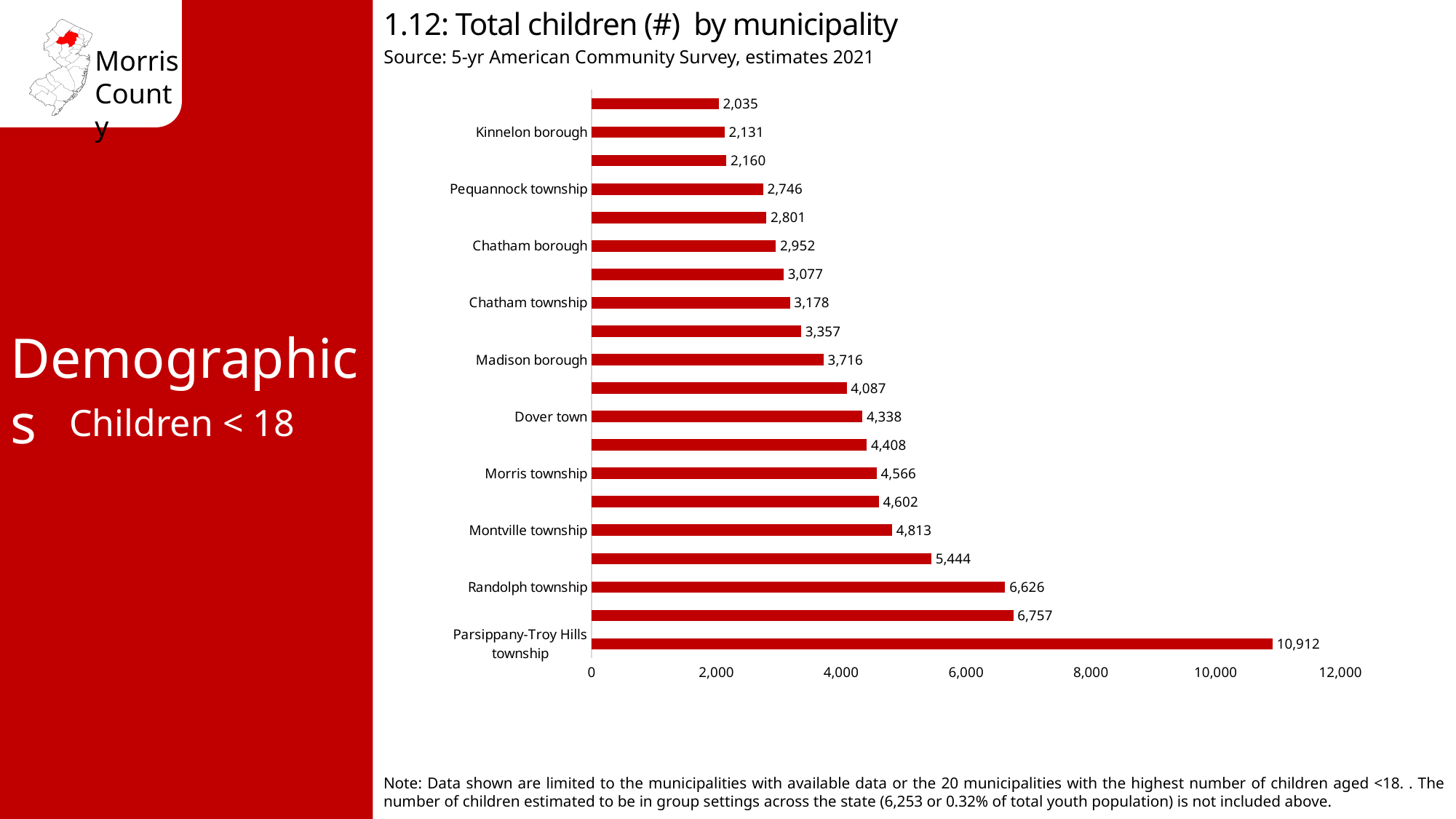
What is the value for Madison borough? 3,716 What kind of chart is shown on the slide? bar chart Is the value for Chatham borough greater or less than 4,000? less Which municipality has the highest number of children? Parsippany-Troy Hills township What is the difference between Morris township and Dover town? 228 What is the value for Parsippany-Troy Hills township? 10,912 What is the difference between Parsippany-Troy Hills township and Randolph township? 4,286 How many bars are plotted on the chart? 20 Which has more children, Montville township or Madison borough? Montville township How many children are shown for Randolph township? 6,626 What is the value for Kinnelon borough? 2,131 What is the smallest value shown on the chart? 2,035